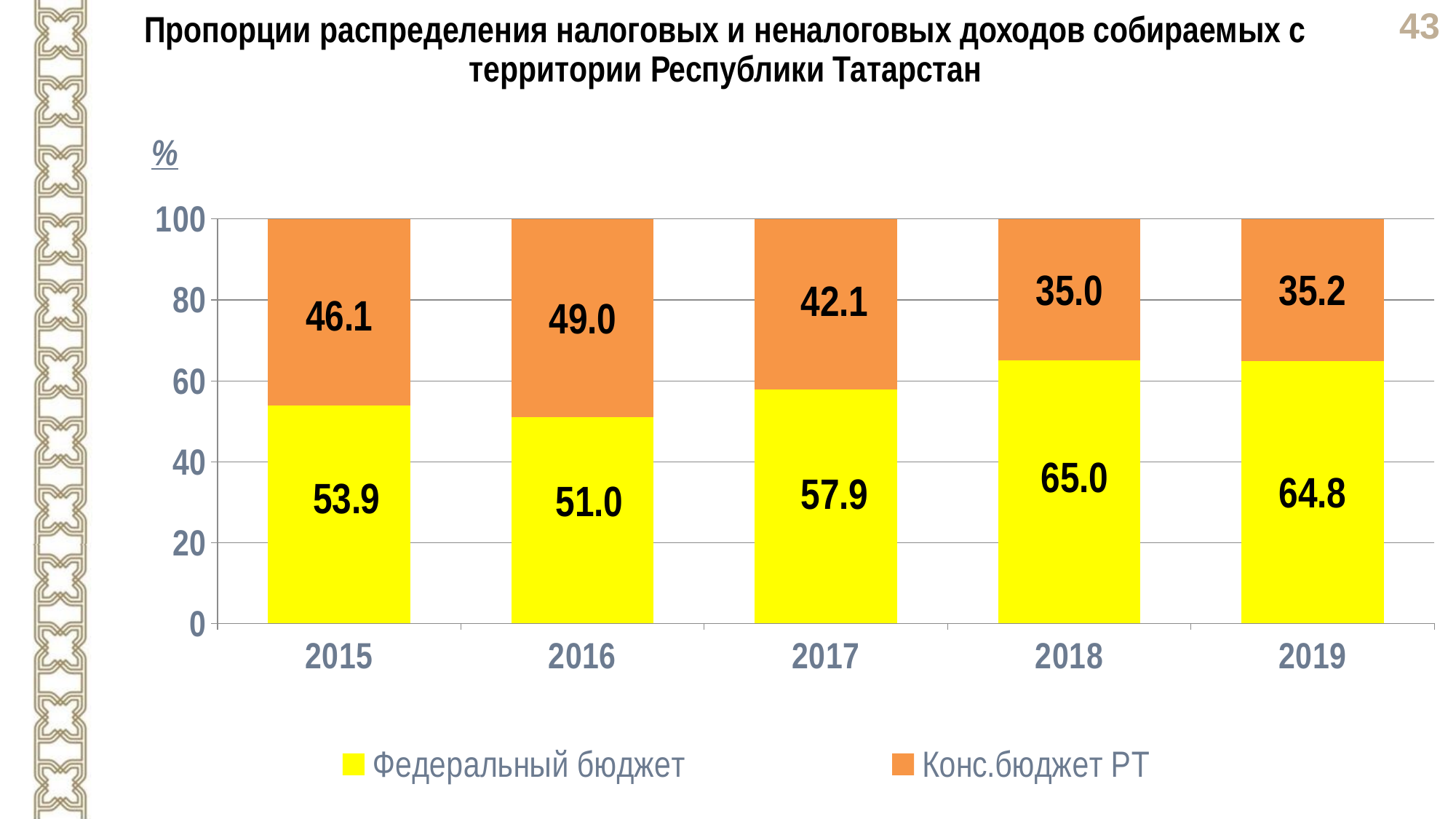
What is the total of the stacked bar for 2017? 100 What is the value for Федеральный бюджет in 2017? 57.9 How many series does the legend list? 2 Which is larger in 2016: Федеральный бюджет or Конс.бюджет РТ? Федеральный бюджет Which colour represents Конс.бюджет РТ in the legend? Orange What is the value for Федеральный бюджет in 2019? 64.8 What is the difference between the Федеральный бюджет values for 2018 and 2015? 11.1 What kind of chart is shown on the slide? Stacked bar chart How many years are shown on the x axis? 5 What is the value for Конс.бюджет РТ in 2016? 49.0 In which year is the Федеральный бюджет share highest? 2018 In which year is the Конс.бюджет РТ share lowest? 2018